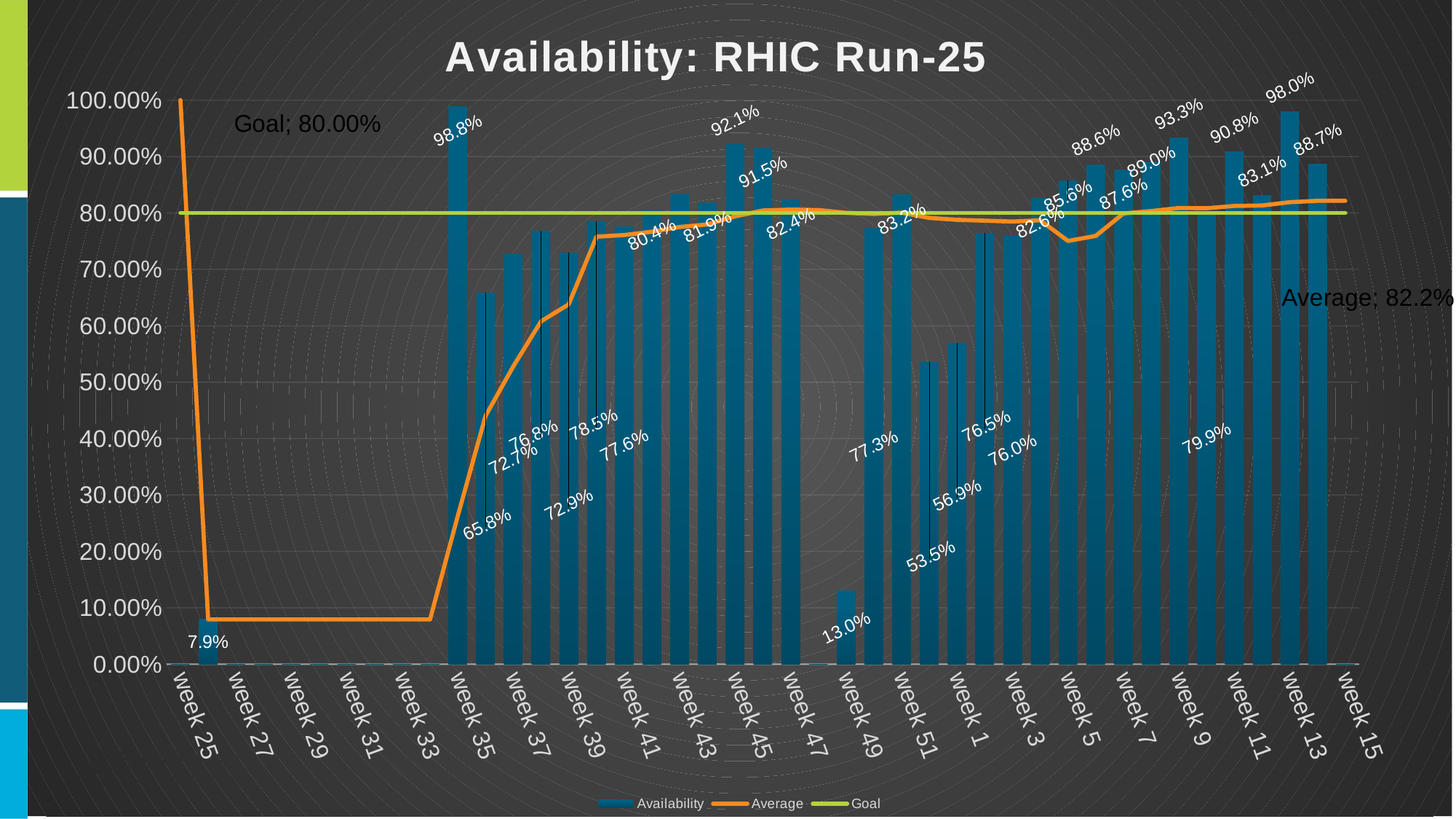
Is the availability value for week 1 greater or less than 60%? less What goal value is shown on the chart? 80.00% What is the availability value for week 49? 13.0% What average value is shown on the chart? 82.2% What are the three entries in the legend? Availability, Average, Goal What kind of chart is shown on the slide? bar chart (with line overlays) How many series does the legend list? 3 Which week has the highest availability value? week 35 What is the availability value for week 13? 98.0% Which has the higher availability, week 9 or week 11? week 9 What is the difference between the availability for week 35 and week 13? 0.8 percentage points What is the availability value for week 35? 98.8%